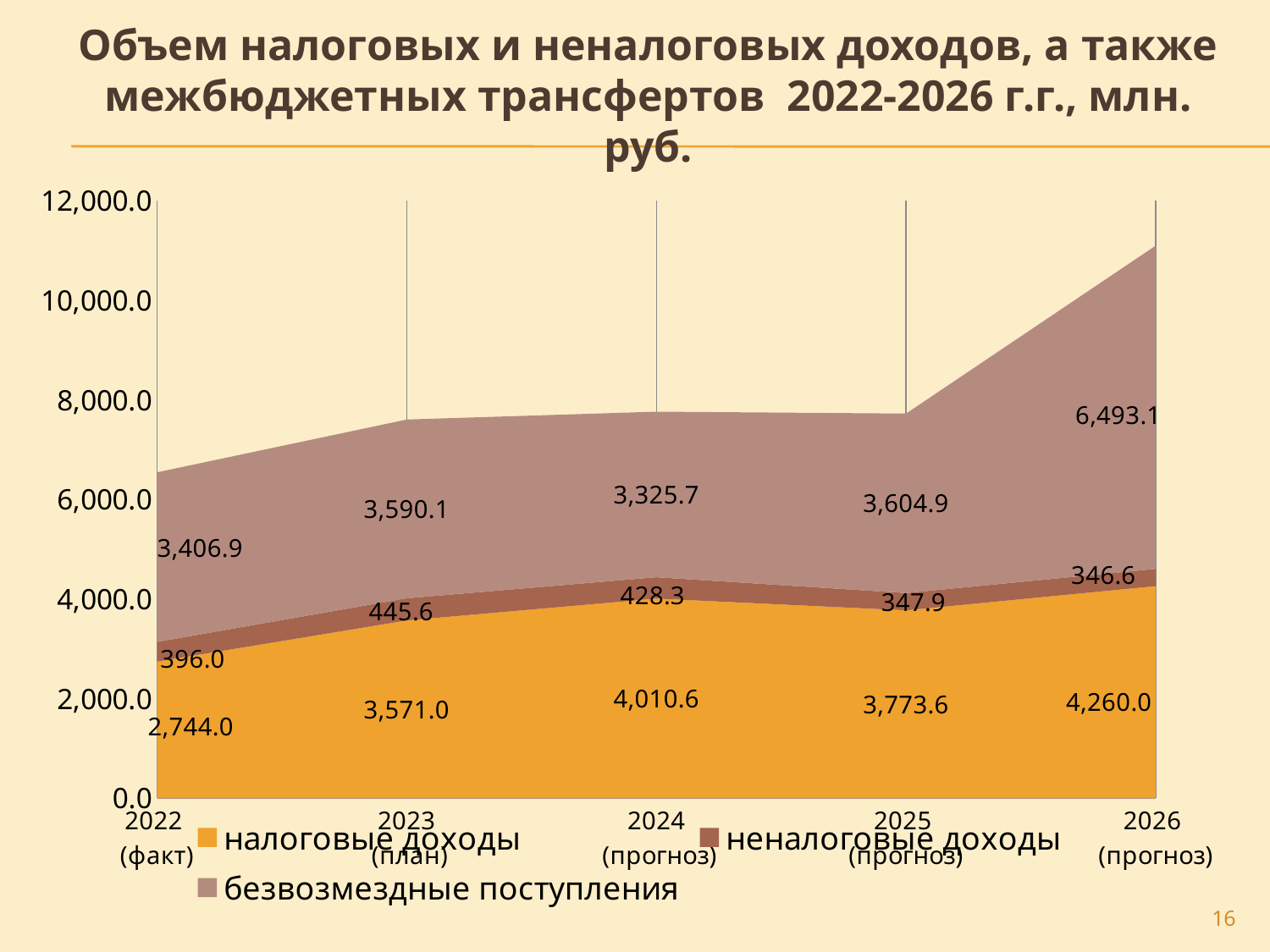
What is the value of неналоговые доходы for 2024 (прогноз)? 428.3 By how much do безвозмездные поступления in 2026 exceed those in 2025? 2,888.2 In which year are неналоговые доходы lowest? 2026 (прогноз) How many series does the legend list? 3 Do неналоговые доходы rise or fall from 2023 to 2026? Fall Which is larger: налоговые доходы in 2024 or in 2025? 2024 How many years are shown on the x axis? 5 What is the value of безвозмездные поступления for 2026 (прогноз)? 6,493.1 What is the value of налоговые доходы for 2022 (факт)? 2,744.0 What is the total of all three series for 2022 (факт)? 6,546.9 In which year are налоговые доходы highest? 2026 (прогноз) What kind of chart is shown on the slide? Stacked area chart